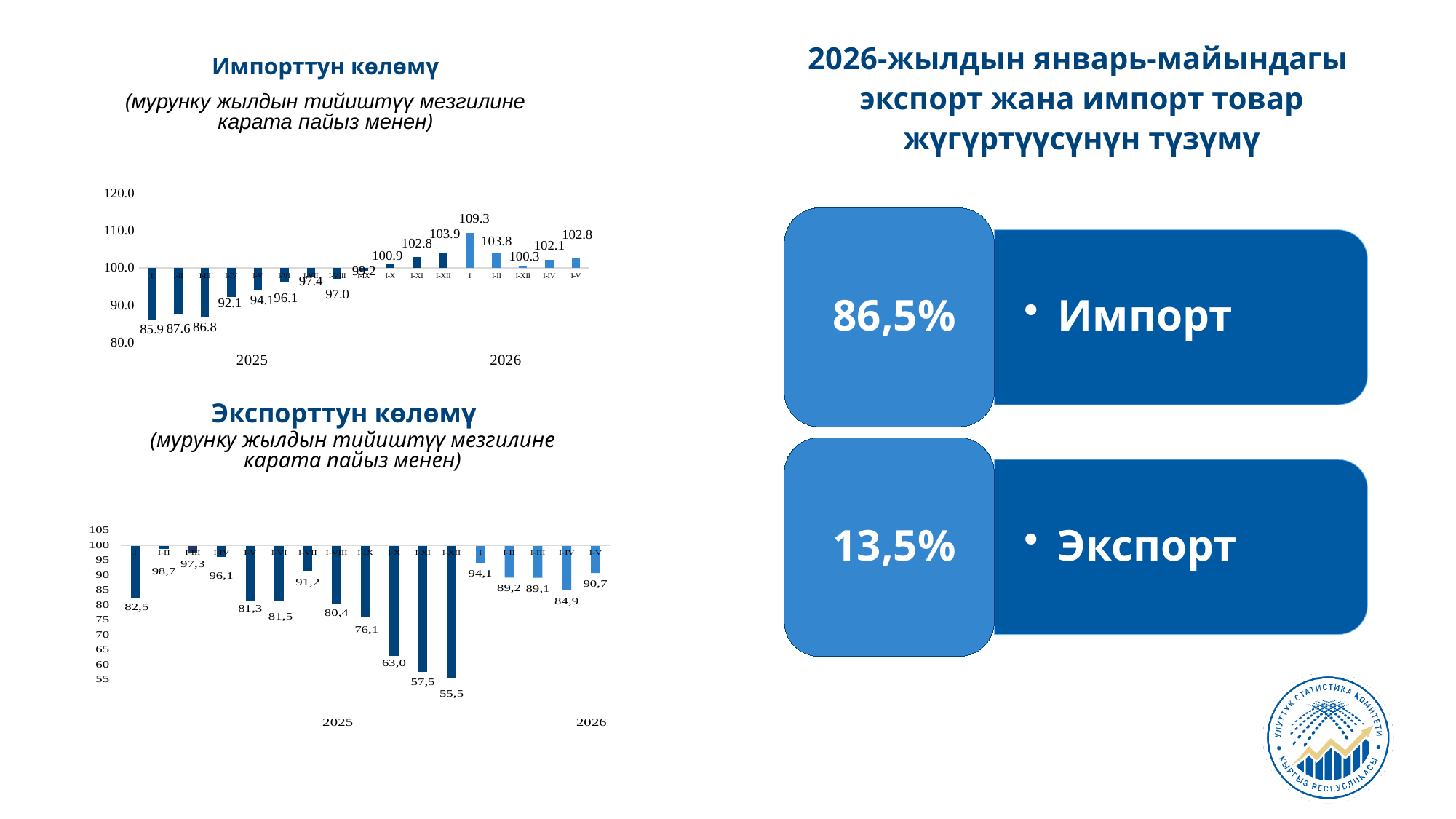
In the Экспорттун көлөмү chart, what is the value for I-V of 2026? 90,7 How many bars are plotted in the Импорттун көлөмү chart? 17 In the Экспорттун көлөмү chart, which is larger: the value for I of 2026 or the value for I-IV of 2026? I of 2026 In the Экспорттун көлөмү chart, what is the difference between the value for I-X of 2025 (63,0) and the value for I-XI of 2025 (57,5)? 5,5 In the Импорттун көлөмү chart, what is the highest value shown? 109.3 In the Импорттун көлөмү chart, what is the lowest value shown? 85.9 What kind of chart is the Экспорттун көлөмү chart? bar chart In the Импорттун көлөмү chart, do the values for 2025 rise or fall from I to I-XII? rise In the Экспорттун көлөмү chart, what is the highest value shown? 98,7 In the Импорттун көлөмү chart, what is the value for I-V of 2026? 102.8 In the Экспорттун көлөмү chart, what is the lowest value shown? 55,5 In the Импорттун көлөмү chart, what is the difference between the value for I of 2026 (109.3) and the value for I-XII of 2025 (103.9)? 5.4